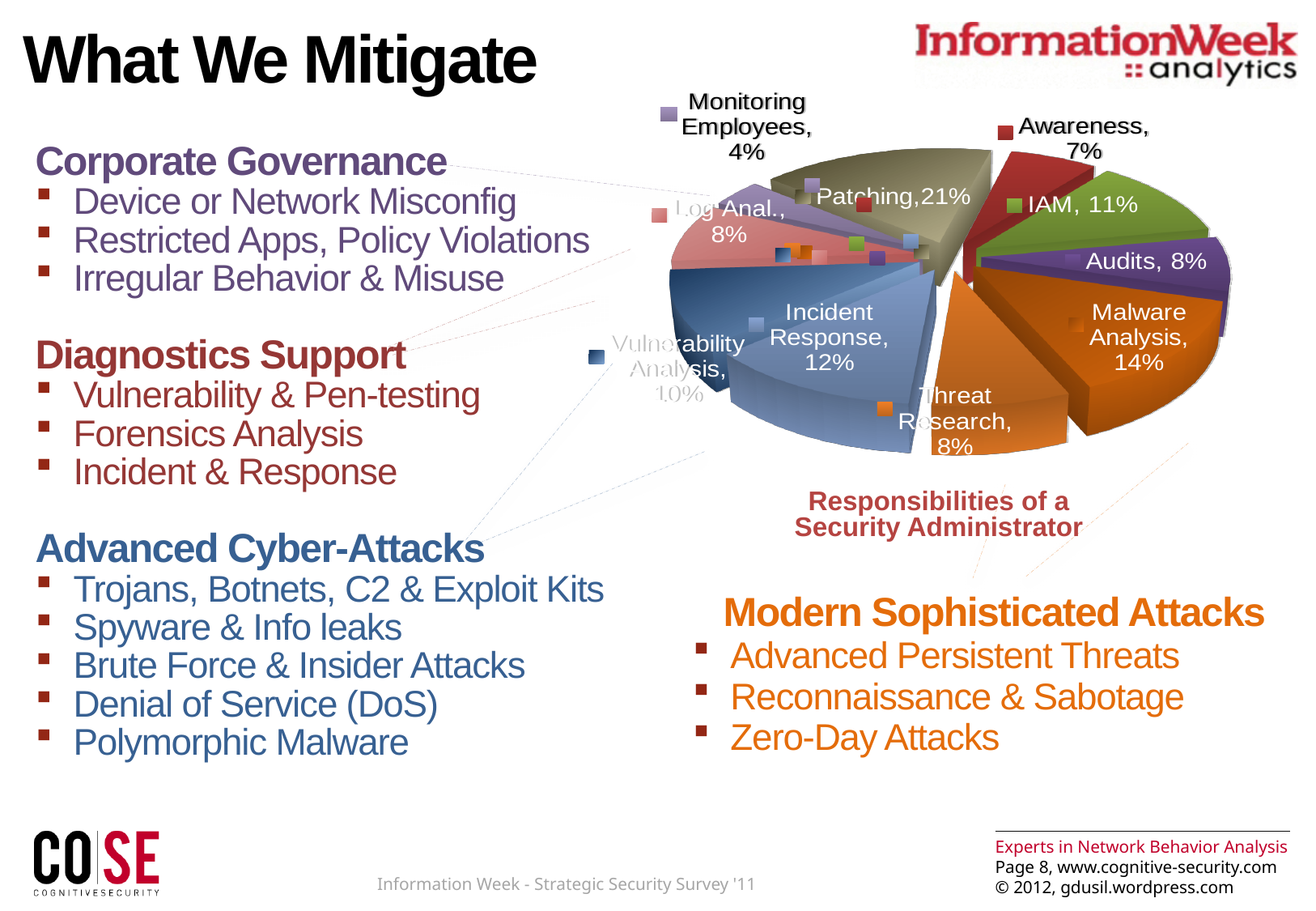
What percentage of the pie chart is Incident Response? 12% What is the title of the pie chart? Responsibilities of a Security Administrator Which is larger in the pie chart, Awareness or IAM? IAM What percentage of the pie chart is Malware Analysis? 14% Which slice of the pie chart is the largest? Patching What percentage of the pie chart is Patching? 21% What is the difference in percentage points between Patching and Malware Analysis in the pie chart? 7 How many slices does the pie chart have? 10 What percentage of the pie chart is IAM? 11% What kind of chart is shown on the slide? pie chart What percentage of the pie chart is Monitoring Employees? 4% Which slice of the pie chart is the smallest? Monitoring Employees